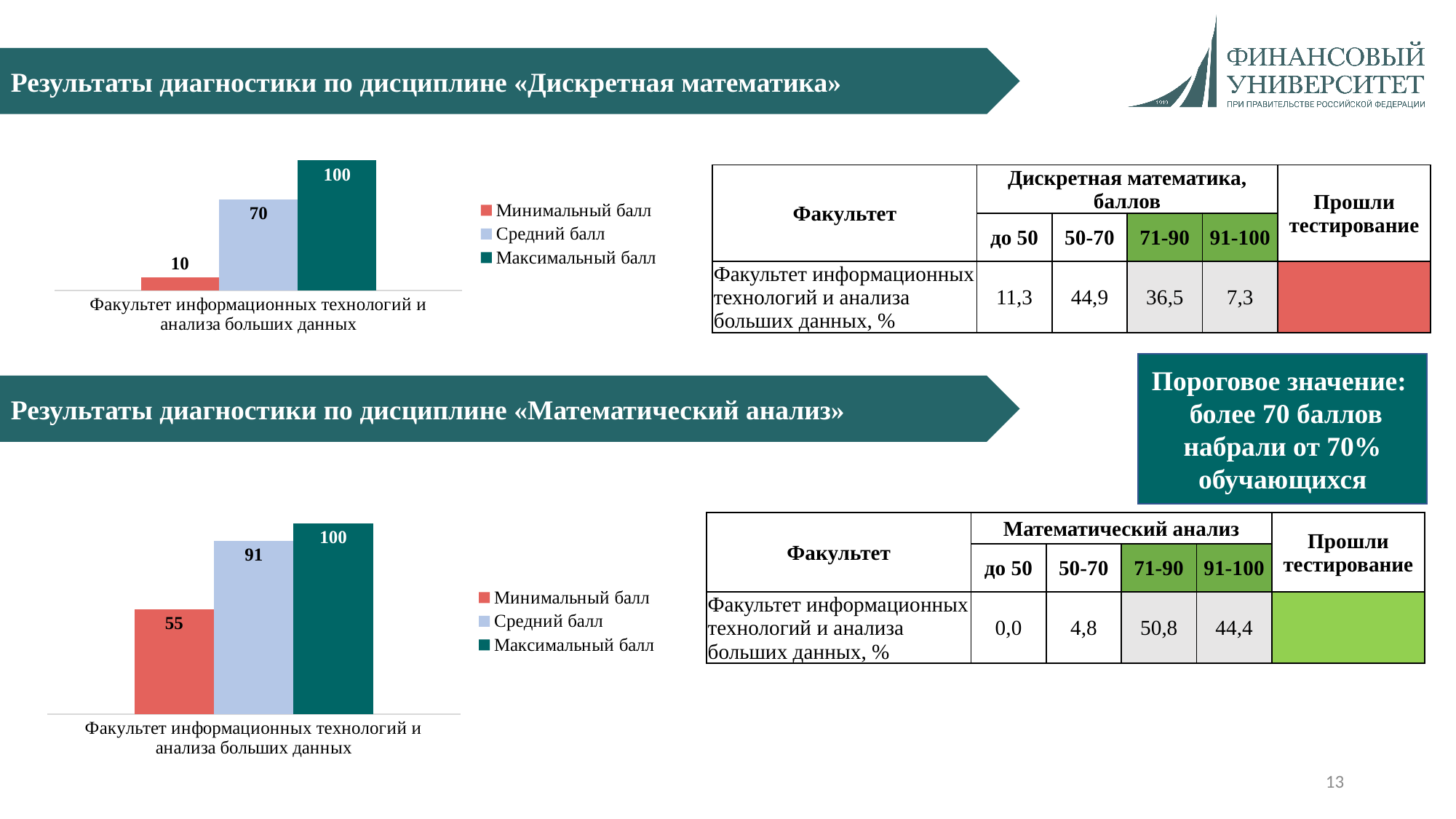
What type of chart is the top chart (Дискретная математика)? Bar chart In the bottom chart (Математический анализ), what is the value for Минимальный балл? 55 Which is larger: Минимальный балл in the top chart (Дискретная математика) or Минимальный балл in the bottom chart (Математический анализ)? Bottom chart (Математический анализ) In the top chart (Дискретная математика), what is the value for Минимальный балл? 10 In the top chart (Дискретная математика), which series has the lowest value? Минимальный балл In the bottom chart (Математический анализ), what is the value for Средний балл? 91 In the top chart (Дискретная математика), what is the difference between Максимальный балл and Средний балл? 30 In the top chart (Дискретная математика), what is the value for Максимальный балл? 100 In the top chart (Дискретная математика), what is the value for Средний балл? 70 In the bottom chart (Математический анализ), which series has the highest value? Максимальный балл How many series does the legend of the bottom chart (Математический анализ) list? 3 In the bottom chart (Математический анализ), what is the difference between Средний балл and Минимальный балл? 36